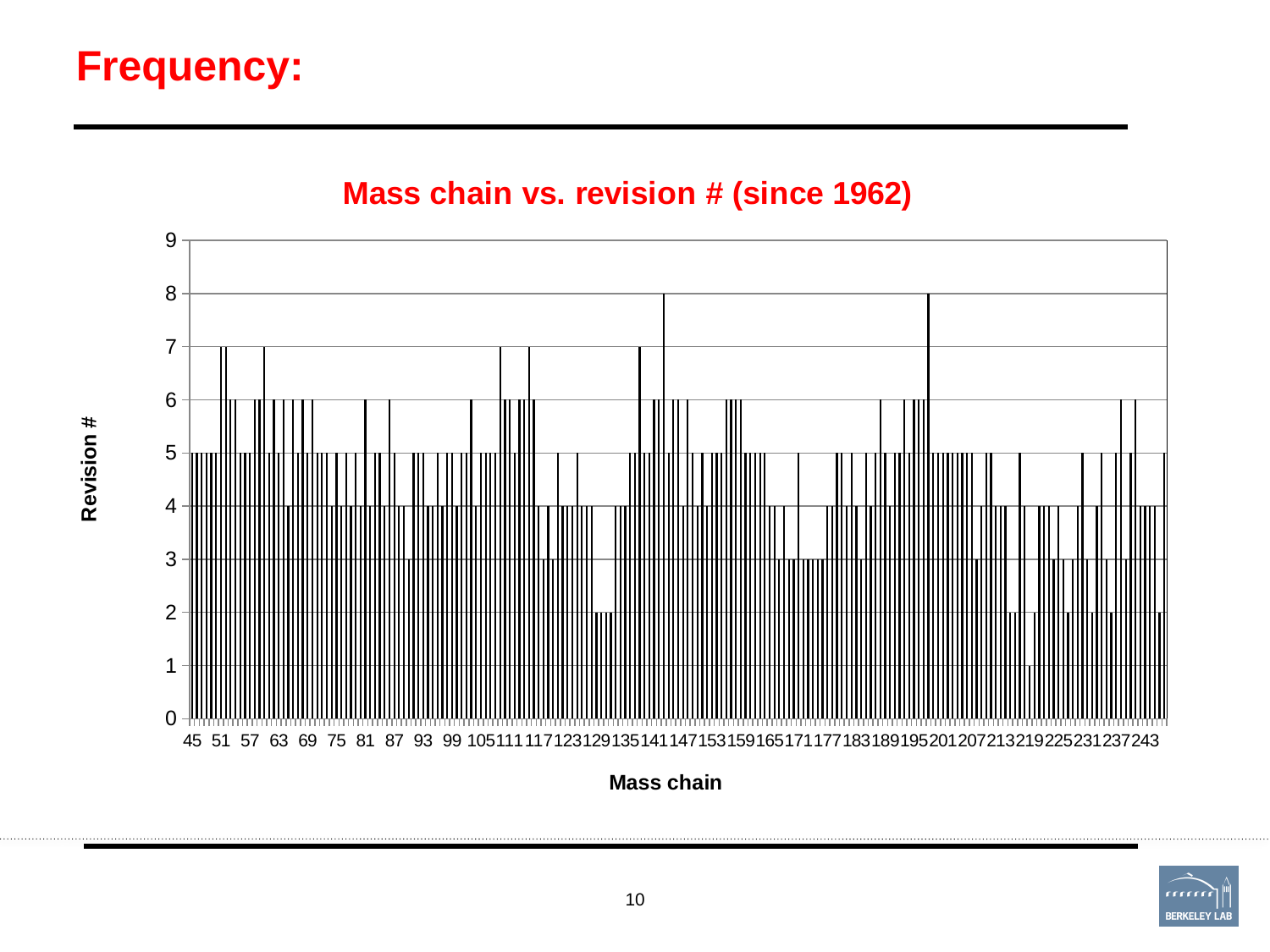
What kind of chart is shown on the slide? bar chart What is the title of the chart? Mass chain vs. revision # (since 1962) What is the highest revision # reached by any bar in the chart? 8 Is the value for mass chain 45 greater or less than 7? less What is the first mass chain label shown on the horizontal axis? 45 What is the highest value shown on the vertical axis? 9 What is the label of the vertical axis? Revision # What is the last mass chain label shown on the horizontal axis? 243 Does any bar in the chart exceed a revision # of 8? No What is the lowest revision # reached by any bar in the chart? 1